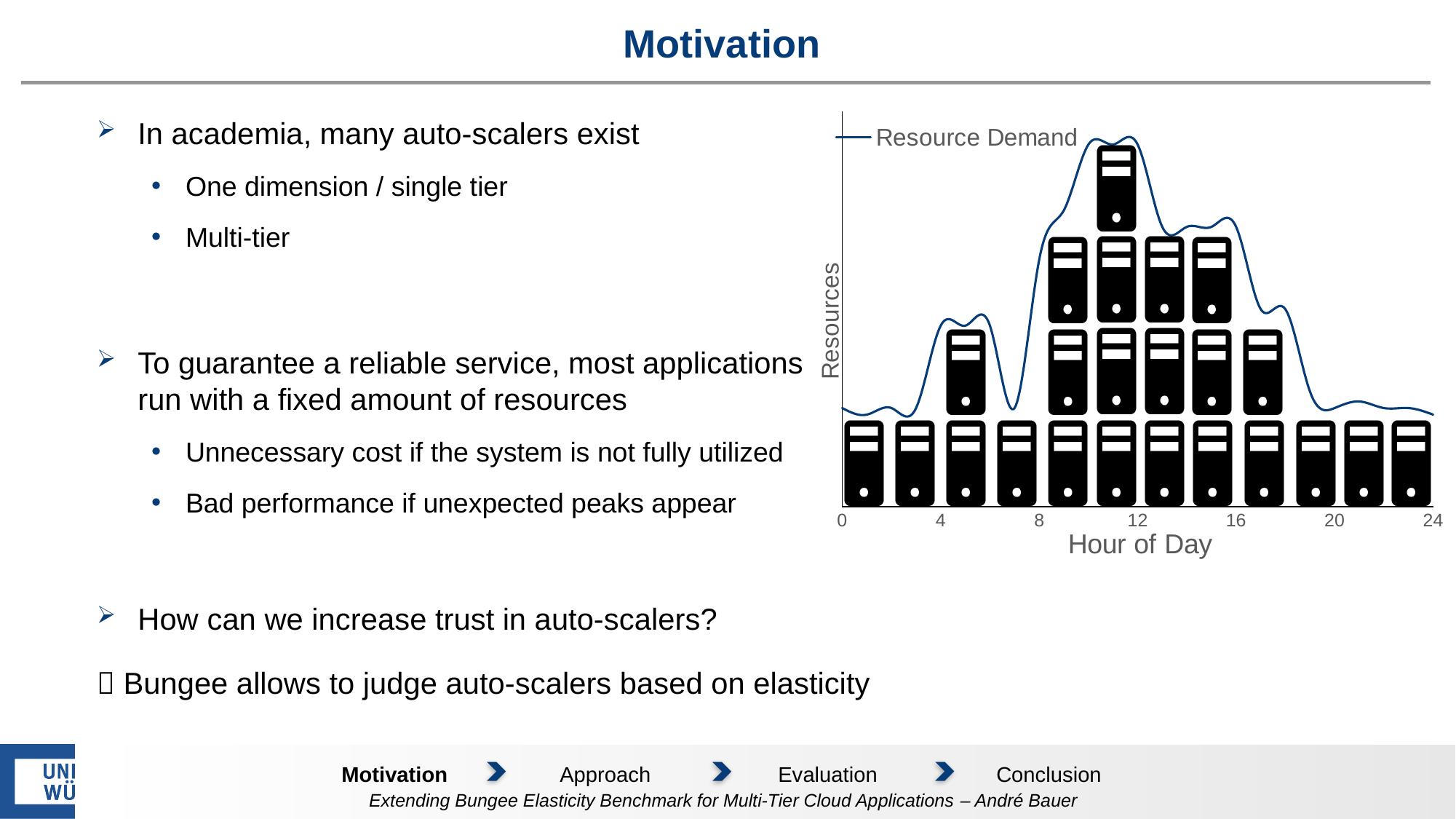
How many server icons are in the bottom row of the chart? 12 Does the Resource Demand line rise or fall between hour 16 and hour 24? fall What kind of chart is shown on the slide? line chart What is the name of the series shown in the chart's legend? Resource Demand What is the label of the x axis of the chart? Hour of Day What is the label of the y axis of the chart? Resources What is the highest value shown on the x axis of the chart? 24 How many tick labels are shown on the x axis of the chart? 7 Does the Resource Demand line rise or fall between hour 8 and hour 12? rise Is the Resource Demand at hour 12 larger or smaller than at hour 4? larger How many series does the chart's legend list? 1